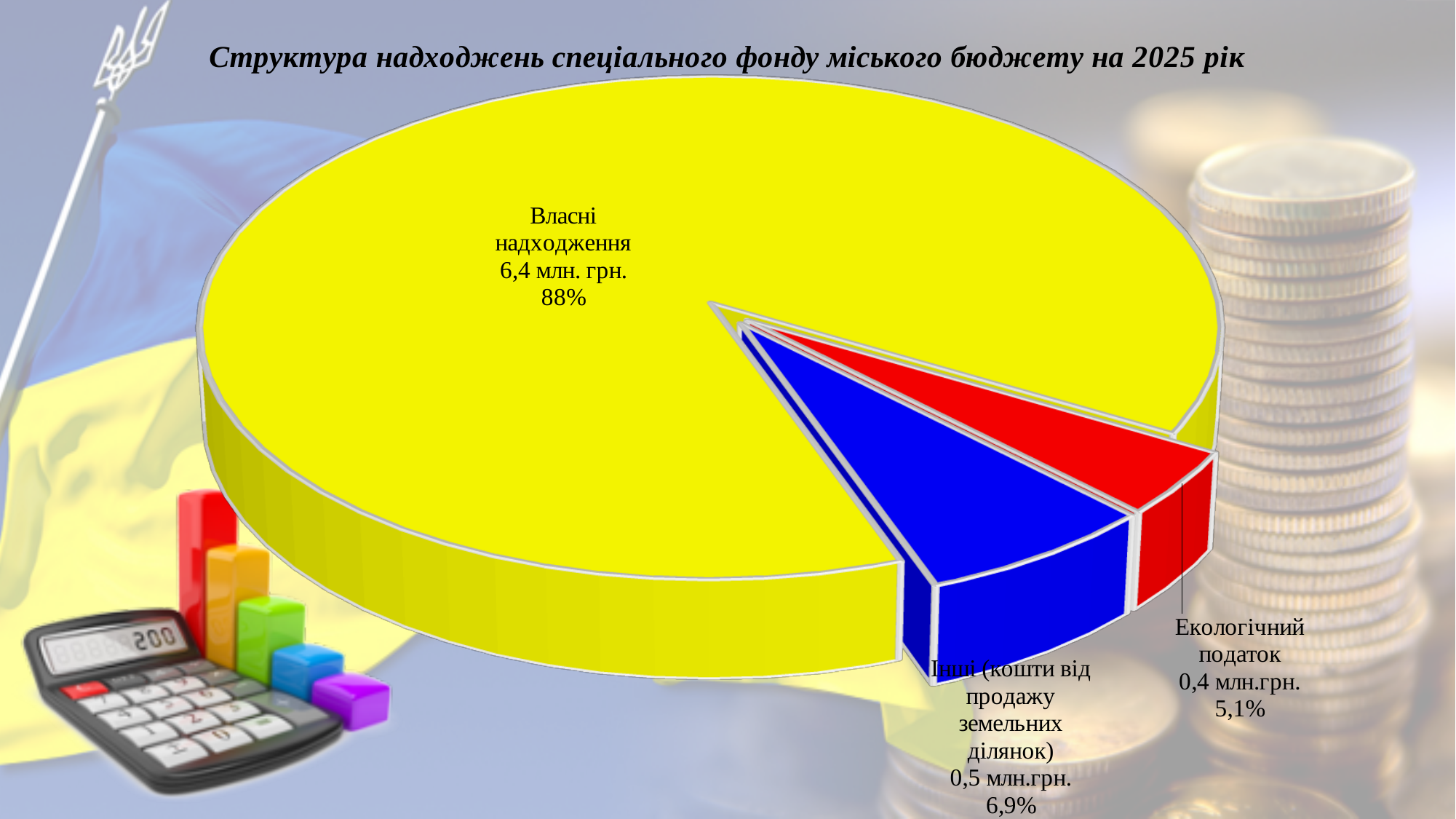
What is the title of the chart? Структура надходжень спеціального фонду міського бюджету на 2025 рік How many slices does the pie chart have? 3 Which colour is used for the Власні надходження slice? Yellow What is the value for Власні надходження? 6,4 млн. грн. What share of the pie does Власні надходження represent? 88% Which category has the smallest slice? Екологічний податок What share of the pie does Екологічний податок represent? 5,1% What share of the pie does Інші (кошти від продажу земельних ділянок) represent? 6,9% What is the value for Інші (кошти від продажу земельних ділянок)? 0,5 млн.грн. Which category has the largest slice? Власні надходження What kind of chart is shown on the slide? Pie chart What is the value for Екологічний податок? 0,4 млн.грн.